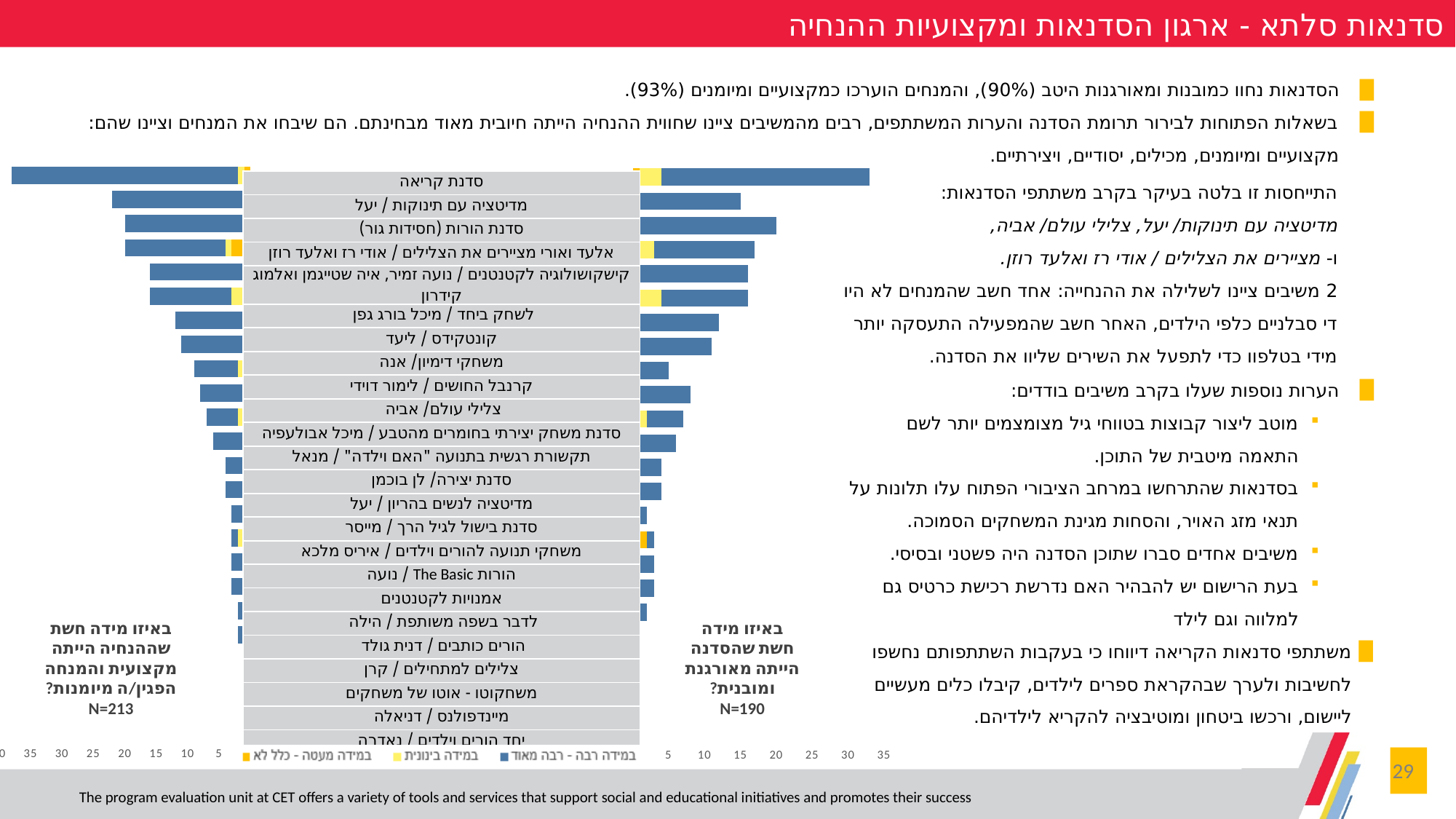
In the left-hand chart (באיזו מידה חשת שההנחיה הייתה מקצועית והמנחה הפגין/ה מיומנות?), which workshop has the longest bar? סדנת קריאה In the left-hand chart (professional facilitation), is the blue value for מדיטציה עם תינוקות / יעל greater or less than 15? greater Which colour in the legend represents 'במידה רבה - רבה מאוד'? blue How many workshop categories are listed in the chart? 24 In the left-hand chart (professional facilitation), is the blue 'במידה רבה - רבה מאוד' value for סדנת קריאה greater or less than 30? greater In the right-hand chart (organized and structured workshop), is the blue value for סדנת הורות (חסידות גור) greater or less than 15? greater In the right-hand chart (באיזו מידה חשת שהסדנה הייתה מאורגנת ומובנית?), which workshop has the longest bar? סדנת קריאה What is the N (number of respondents) shown for the right-hand chart about whether the workshop was organized and structured? N=190 How many series does the chart legend list? 3 In the left-hand chart (professional facilitation), which has the longer blue bar: מדיטציה עם תינוקות / יעל or לשחק ביחד / מיכל בורג גפן? מדיטציה עם תינוקות / יעל What kind of chart is shown on the slide? bar chart